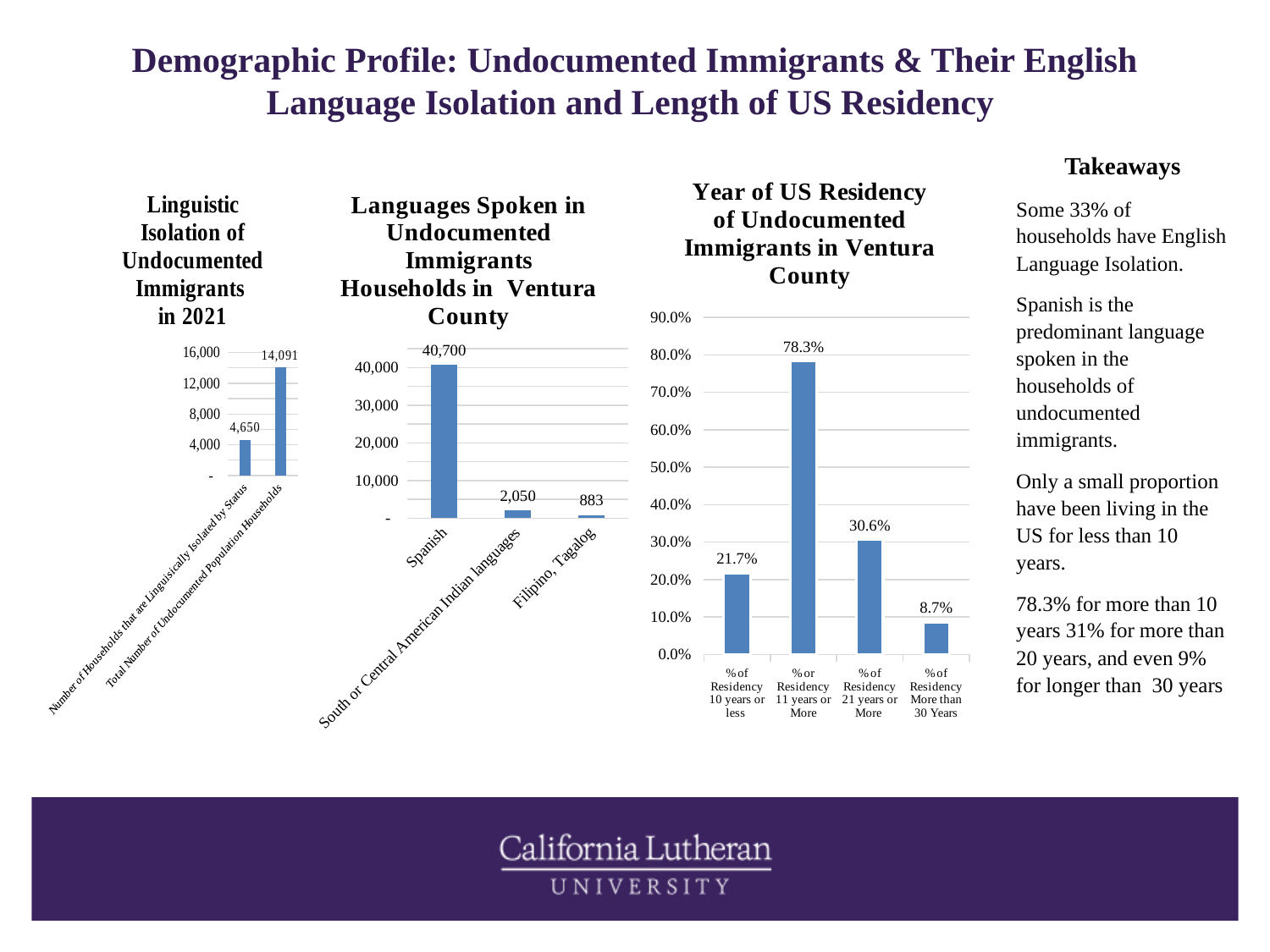
In the 'Languages Spoken in Undocumented Immigrants Households in Ventura County' chart, what is the value for Spanish? 40,700 In the 'Linguistic Isolation of Undocumented Immigrants in 2021' chart, what is the difference between the total number of undocumented population households and the number of linguistically isolated households? 9,441 In the 'Year of US Residency of Undocumented Immigrants in Ventura County' chart, which is larger: % of Residency 10 years or less or % of Residency 21 years or More? % of Residency 21 years or More In the 'Linguistic Isolation of Undocumented Immigrants in 2021' chart, what is the value for Total Number of Undocumented Population Households? 14,091 In the 'Year of US Residency of Undocumented Immigrants in Ventura County' chart, which category has the lowest value? % of Residency More than 30 Years In the 'Languages Spoken in Undocumented Immigrants Households in Ventura County' chart, how many language categories are shown? 3 What type of chart is the 'Year of US Residency of Undocumented Immigrants in Ventura County' chart? Bar chart In the 'Languages Spoken in Undocumented Immigrants Households in Ventura County' chart, which language category has the lowest value? Filipino, Tagalog In the 'Linguistic Isolation of Undocumented Immigrants in 2021' chart, what is the value for Number of Households that are Linguistically Isolated by Status? 4,650 In the 'Year of US Residency of Undocumented Immigrants in Ventura County' chart, what is the value for % or Residency 11 years or More? 78.3% In the 'Languages Spoken in Undocumented Immigrants Households in Ventura County' chart, what is the difference between South or Central American Indian languages and Filipino, Tagalog? 1,167 In the 'Languages Spoken in Undocumented Immigrants Households in Ventura County' chart, what is the value for Filipino, Tagalog? 883